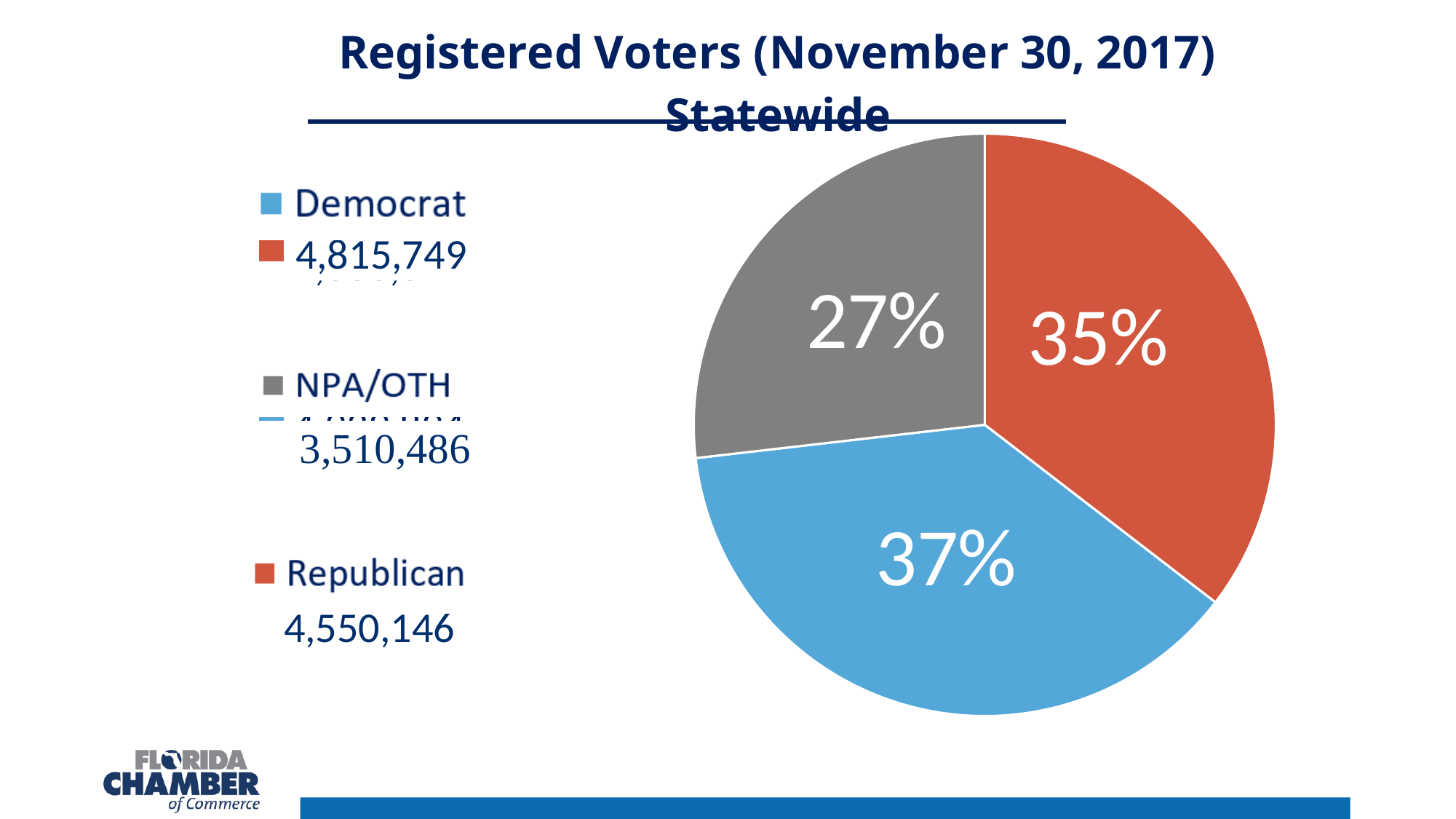
What percentage of registered voters are NPA/OTH according to the pie chart? 27% What percentage of registered voters are Republicans according to the pie chart? 35% What kind of chart is shown on the slide? Pie chart By how many percentage points does the Democrat share exceed the Republican share? 2 percentage points Which has a larger share of registered voters, Republican or NPA/OTH? Republican Which category has the smallest share of registered voters in the pie chart? NPA/OTH Which party has the largest share of registered voters in the pie chart? Democrat What is the title of the chart? Registered Voters (November 30, 2017) Statewide How many slices does the pie chart have? 3 What percentage of registered voters are Democrats according to the pie chart? 37%